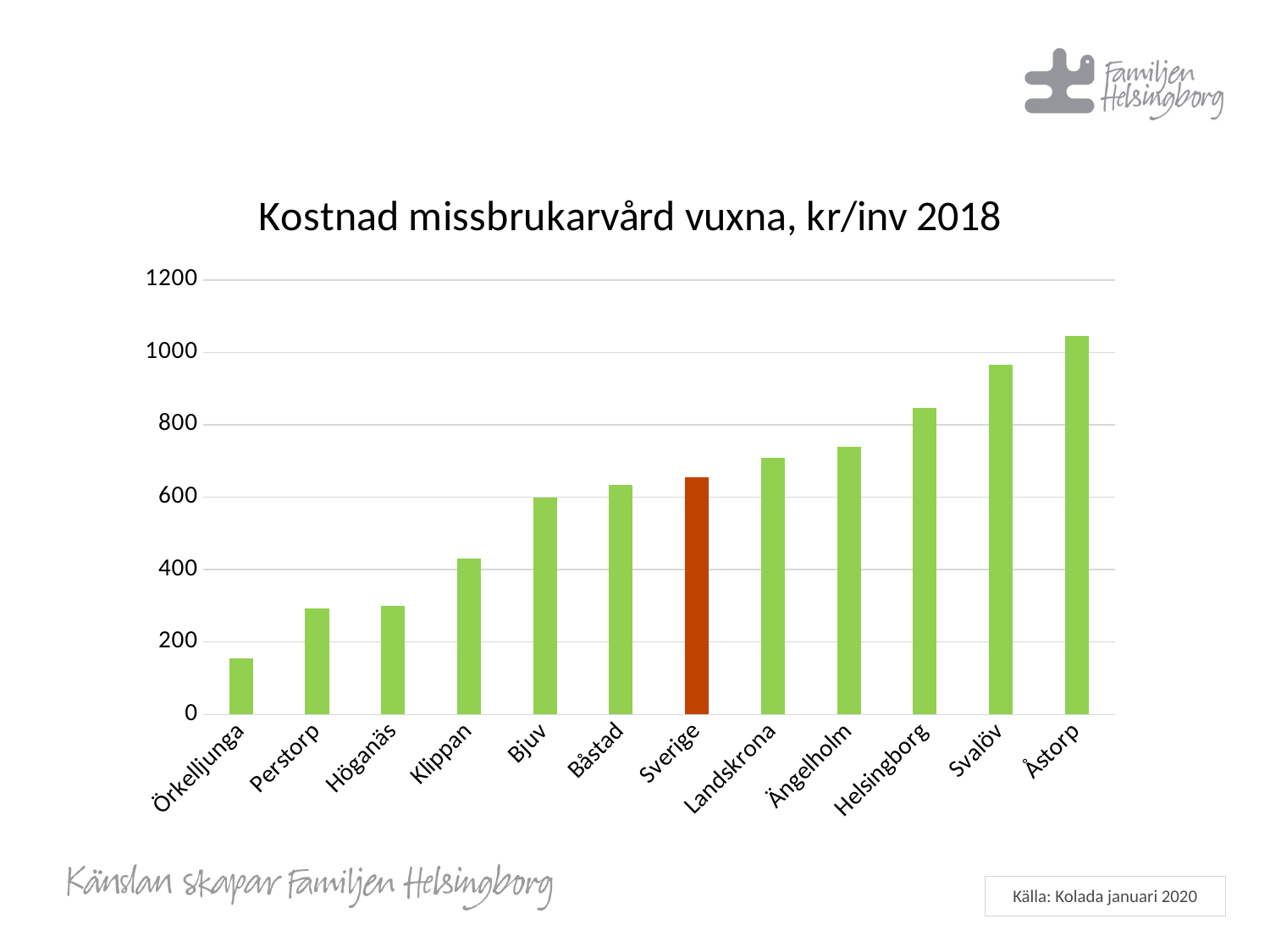
Is the value for Örkelljunga greater or less than 200? less Which category has the lowest value? Örkelljunga Is the value for Svalöv greater or less than 1000? less Which category has the highest value? Åstorp How many categories are shown on the x axis? 12 Which is larger, the value for Helsingborg or the value for Sverige? Helsingborg What is the title of the chart? Kostnad missbrukarvård vuxna, kr/inv 2018 What kind of chart is shown on the slide? bar chart Is the value for Åstorp greater or less than 1000? greater Which category's bar is shown in a different colour from the others? Sverige Do the values rise or fall from left to right along the x axis? rise